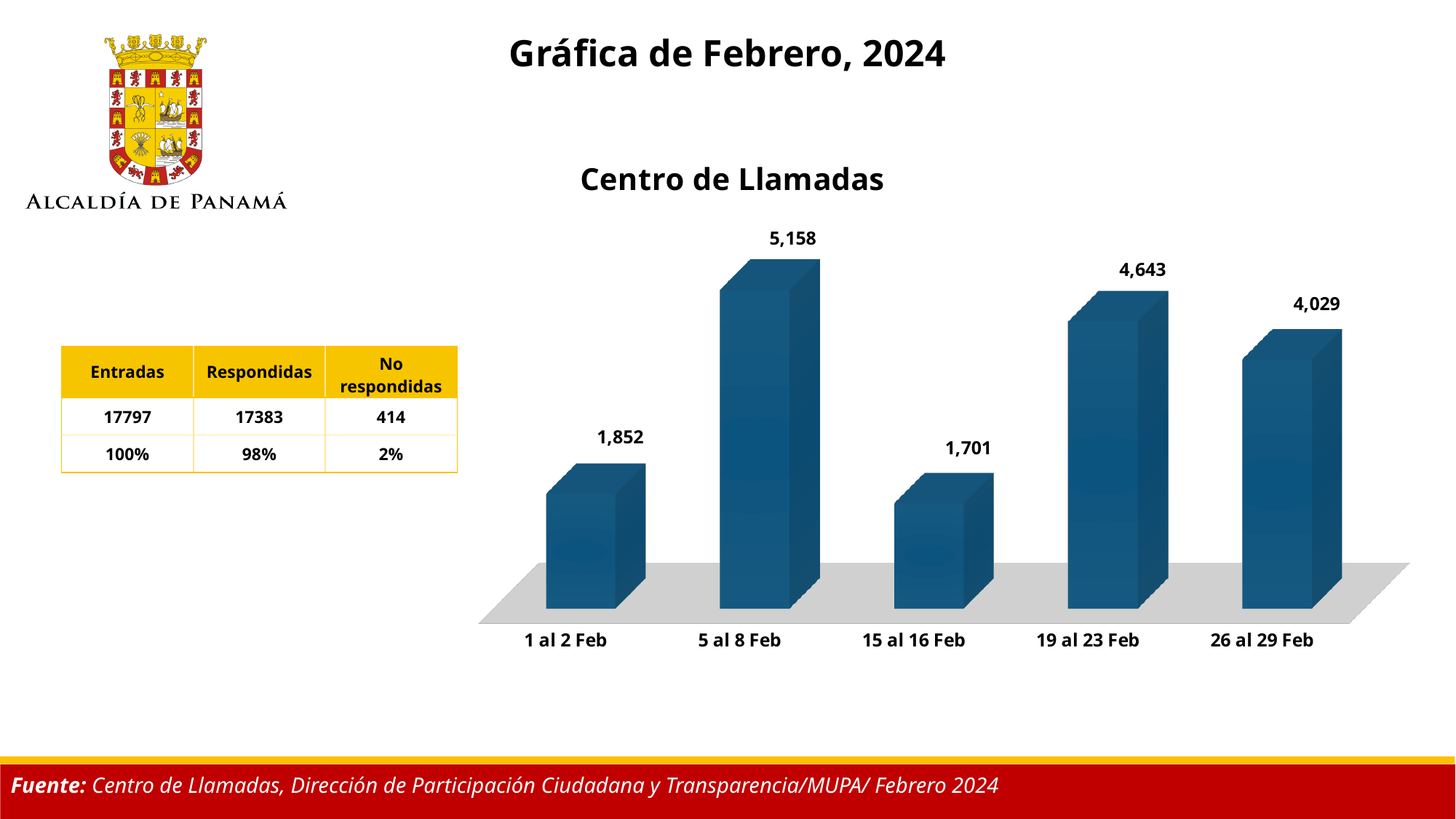
What colour are the bars in the Centro de Llamadas chart? Blue How many periods are shown in the Centro de Llamadas chart? 5 Which period has the highest value in the Centro de Llamadas chart? 5 al 8 Feb What is the value for 26 al 29 Feb in the Centro de Llamadas chart? 4,029 Which is larger, the value for 19 al 23 Feb or the value for 26 al 29 Feb? 19 al 23 Feb What is the title of the chart on the slide? Centro de Llamadas What is the value for 1 al 2 Feb in the Centro de Llamadas chart? 1,852 What kind of chart is the Centro de Llamadas chart? Bar chart What is the difference between the values for 1 al 2 Feb and 15 al 16 Feb? 151 What is the value for 5 al 8 Feb in the Centro de Llamadas chart? 5,158 What is the difference between the values for 5 al 8 Feb and 19 al 23 Feb? 515 Which period has the lowest value in the Centro de Llamadas chart? 15 al 16 Feb